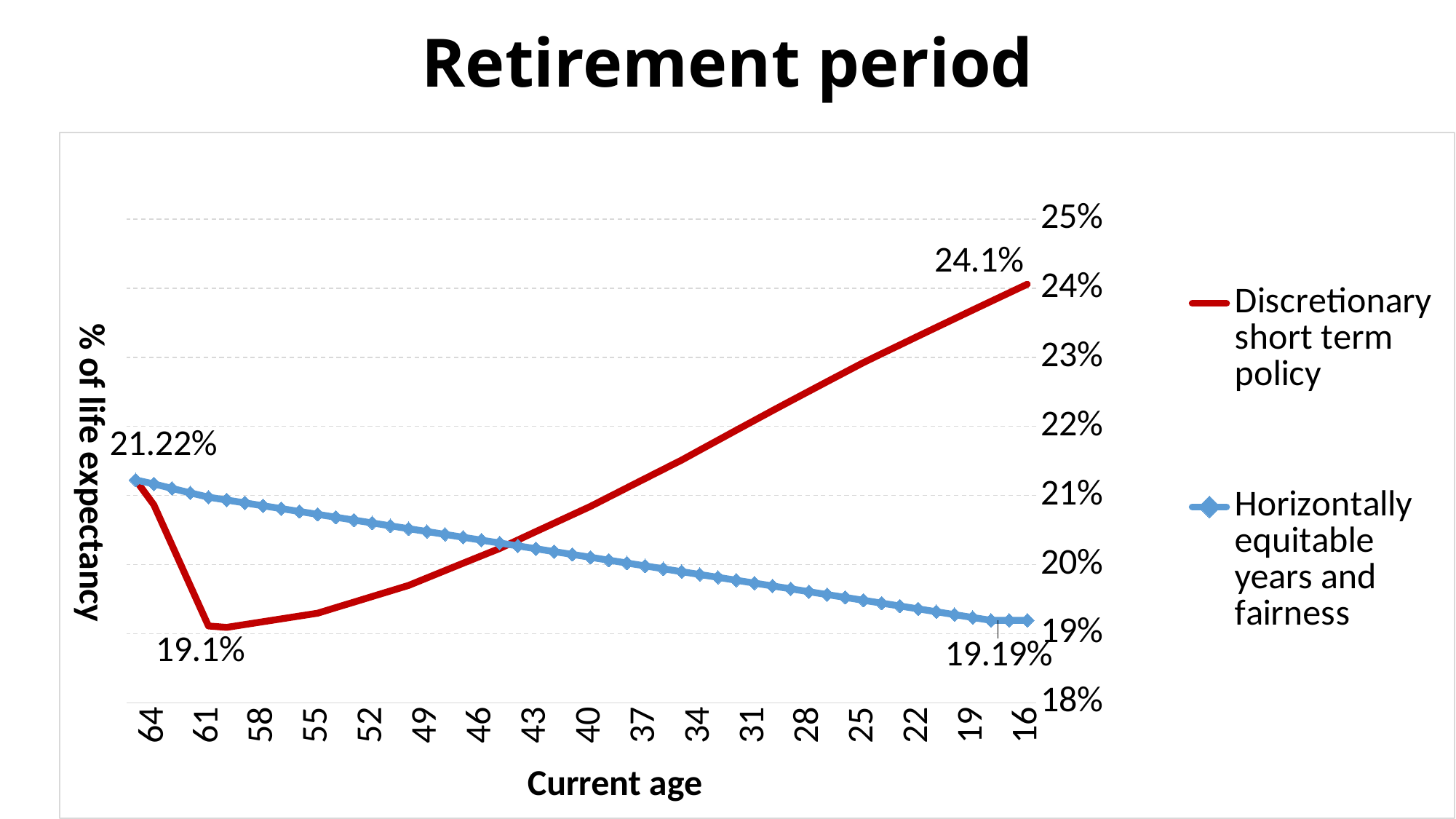
What is the difference between the two series at current age 16? 4.91 percentage points At current age 16, which series has the higher value? Discretionary short term policy What is the value of the Discretionary short term policy series at current age 16? 24.1% Does the Horizontally equitable years and fairness series rise or fall as current age goes from 64 to 16 along the x axis? falls What is the value of the Horizontally equitable years and fairness series at current age 16? 19.19% Is the value of the Discretionary short term policy series at current age 40 greater or less than 20%? greater How many series does the legend list? 2 What type of chart is shown on the slide? line chart What is the lowest labelled value of the Discretionary short term policy series? 19.1% What is the title of the x axis? Current age